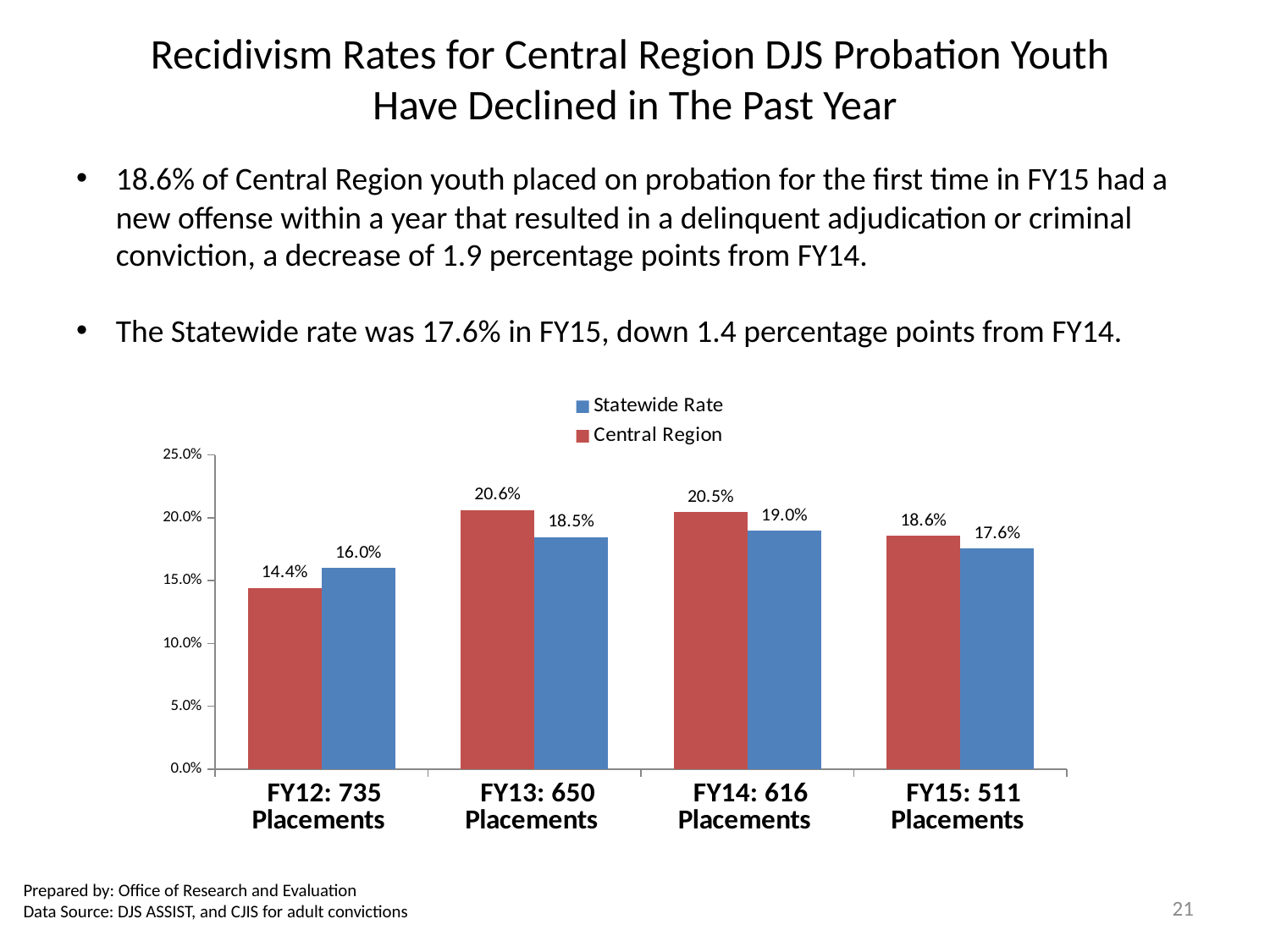
What is the Central Region rate for FY12: 735 Placements? 14.4% What is the Central Region recidivism rate for FY15: 511 Placements? 18.6% What kind of chart is shown on the slide? bar chart What is the difference between the Central Region rate and the Statewide Rate for FY14: 616 Placements? 1.5 percentage points What is the Statewide Rate for FY13: 650 Placements? 18.5% Which colour represents the Central Region series? red For FY12: 735 Placements, which is larger, the Central Region rate or the Statewide Rate? Statewide Rate How many series does the legend list? 2 Which fiscal year has the lowest Statewide Rate? FY12: 735 Placements Which fiscal year has the highest Central Region rate? FY13: 650 Placements Is the Statewide Rate for FY15: 511 Placements greater or less than 20.0%? less How many fiscal year categories are shown on the x axis? 4